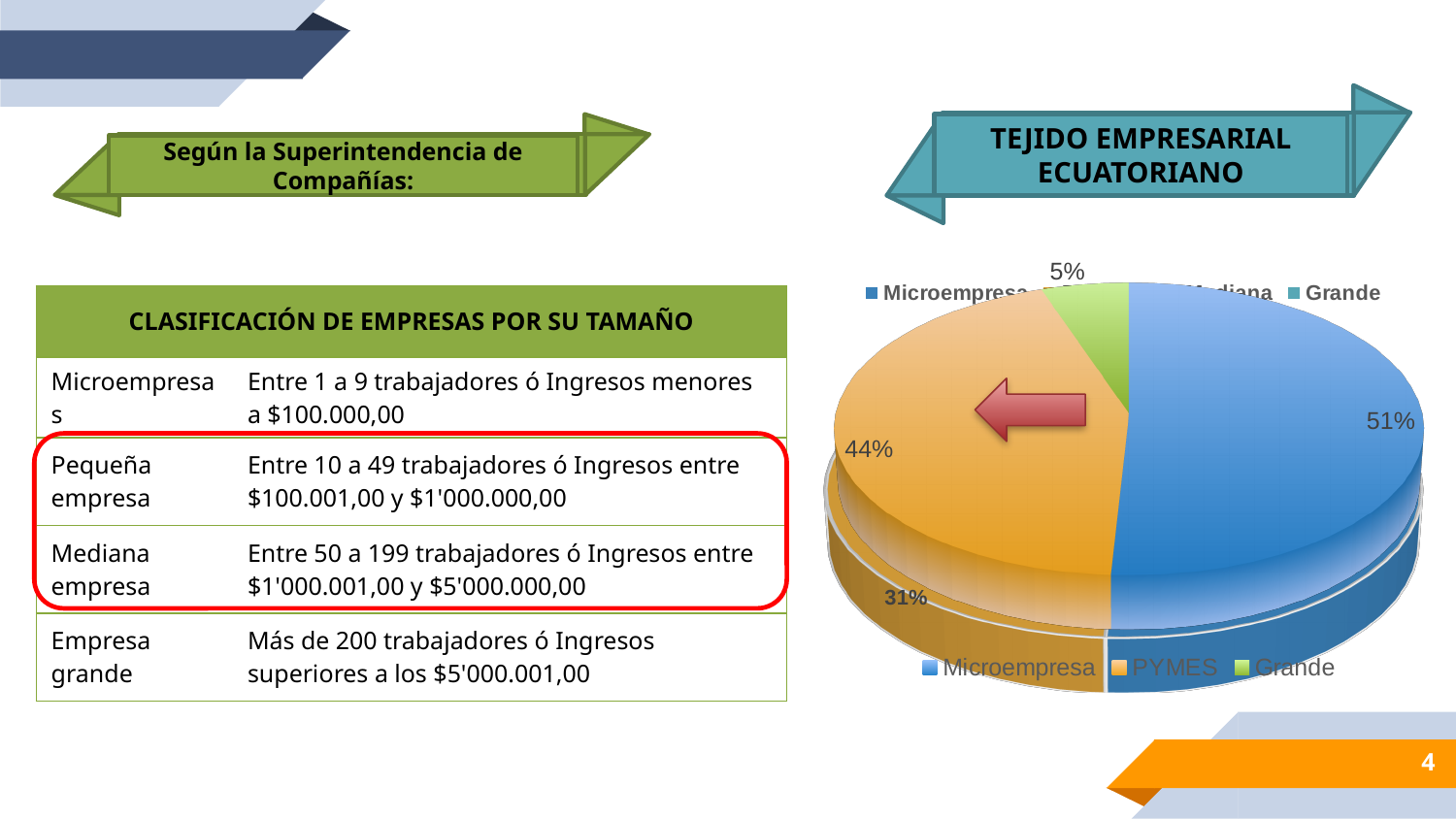
What type of chart is shown on the slide? Pie chart What share of the pie chart does Microempresa represent? 51% What is the title shown above the pie chart? TEJIDO EMPRESARIAL ECUATORIANO Which category has the largest slice in the pie chart? Microempresa What share of the pie chart does Grande represent? 5% What share of the pie chart does PYMES represent? 44% How many categories does the pie chart's legend list? 3 By how many percentage points does the Microempresa slice exceed the PYMES slice? 7 percentage points What colour represents Grande in the pie chart? Green Which category has the smallest slice in the pie chart? Grande Which slice is larger, PYMES or Grande? PYMES